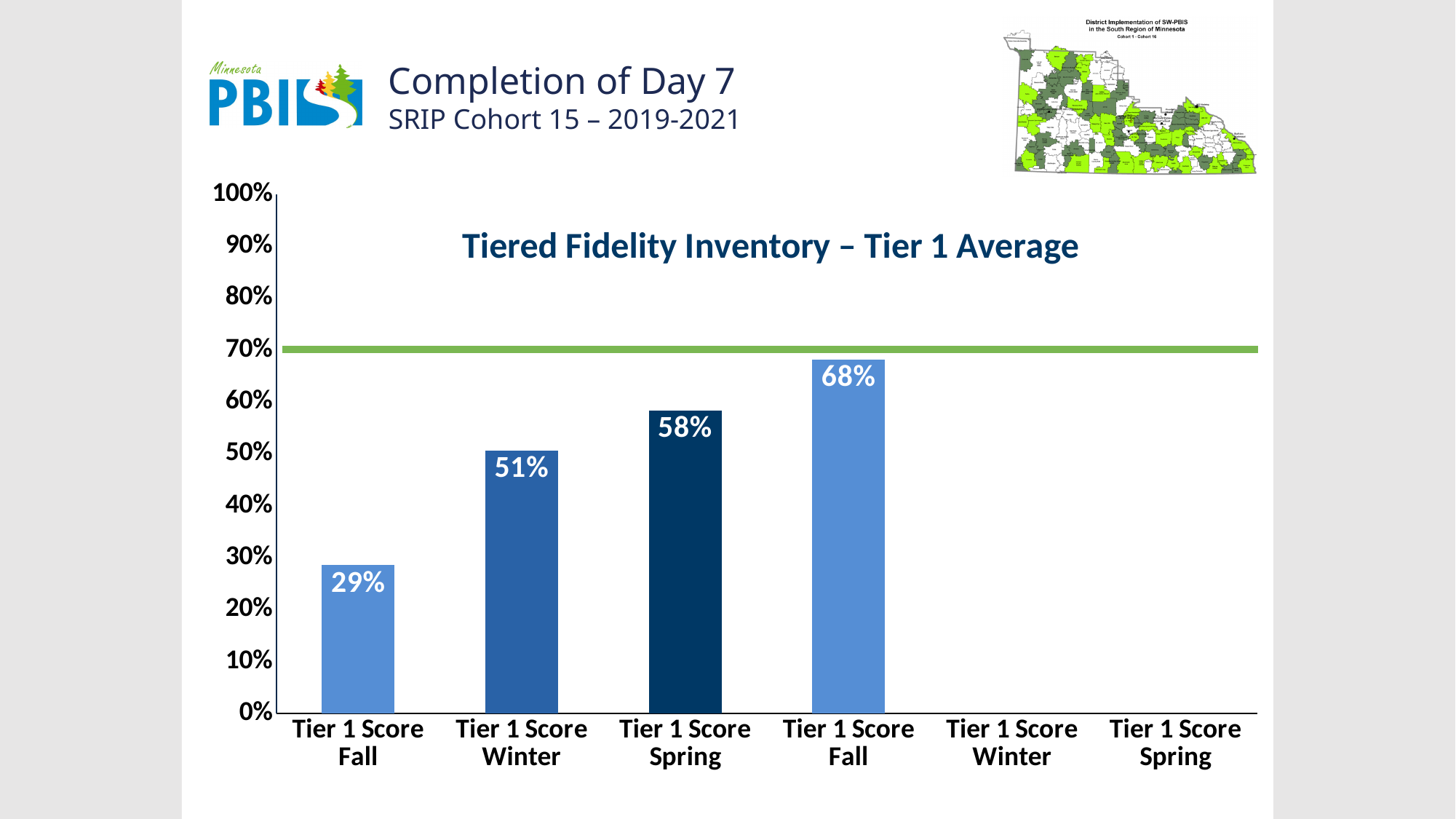
Which bar has the lowest value? Tier 1 Score Fall (first bar, 29%) At what value on the y axis is the horizontal green line drawn? 70% What is the title of the chart? Tiered Fidelity Inventory – Tier 1 Average What is the value of the Tier 1 Score Spring bar? 58% What is the value of the first bar, Tier 1 Score Fall? 29% What is the difference between the Tier 1 Score Spring bar and the Tier 1 Score Winter bar? 7% Which bar has the highest value? Tier 1 Score Fall (fourth bar, 68%) How many category labels are shown on the x axis? 6 What kind of chart is shown on the slide? bar chart What is the value of the fourth bar, the second Tier 1 Score Fall? 68% Do the plotted bar values rise or fall from left to right? rise What is the value of the Tier 1 Score Winter bar? 51%